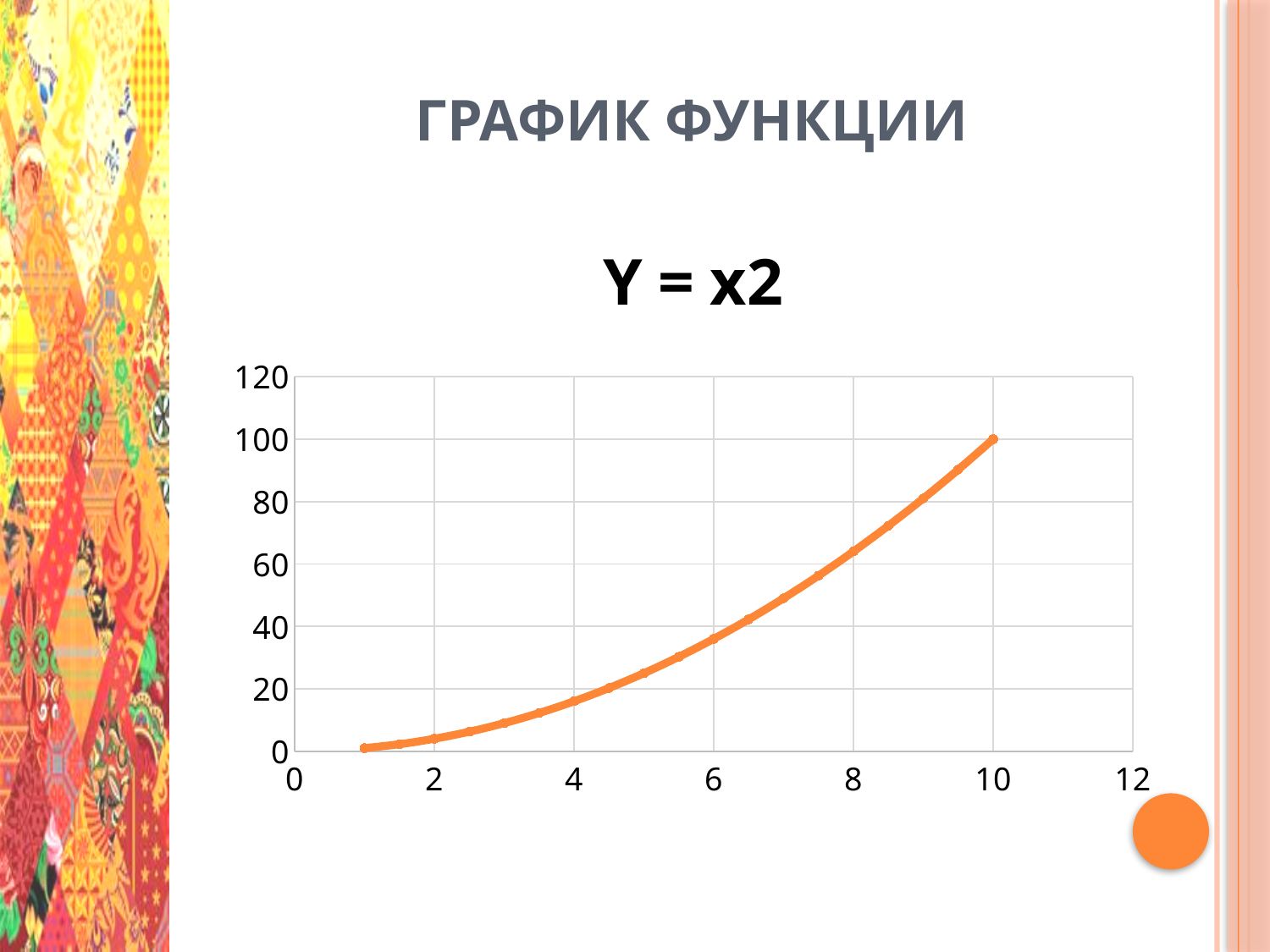
What kind of chart is shown on the slide? line chart Do the values rise or fall as x increases along the x axis? rise Is the value of the curve at x = 4 greater or less than 20? less Is the value of the curve at x = 2 greater or less than 20? less What is the highest value shown on the vertical axis? 120 At which x value does the curve reach its highest point? 10 What is the title of the chart? Y = x2 Is the value of the curve at x = 8 greater or less than 40? greater Which is larger, the value of the curve at x = 4 or at x = 8? x = 8 What is the value of the curve at x = 10? 100 At which x value is the curve at its lowest point? 1